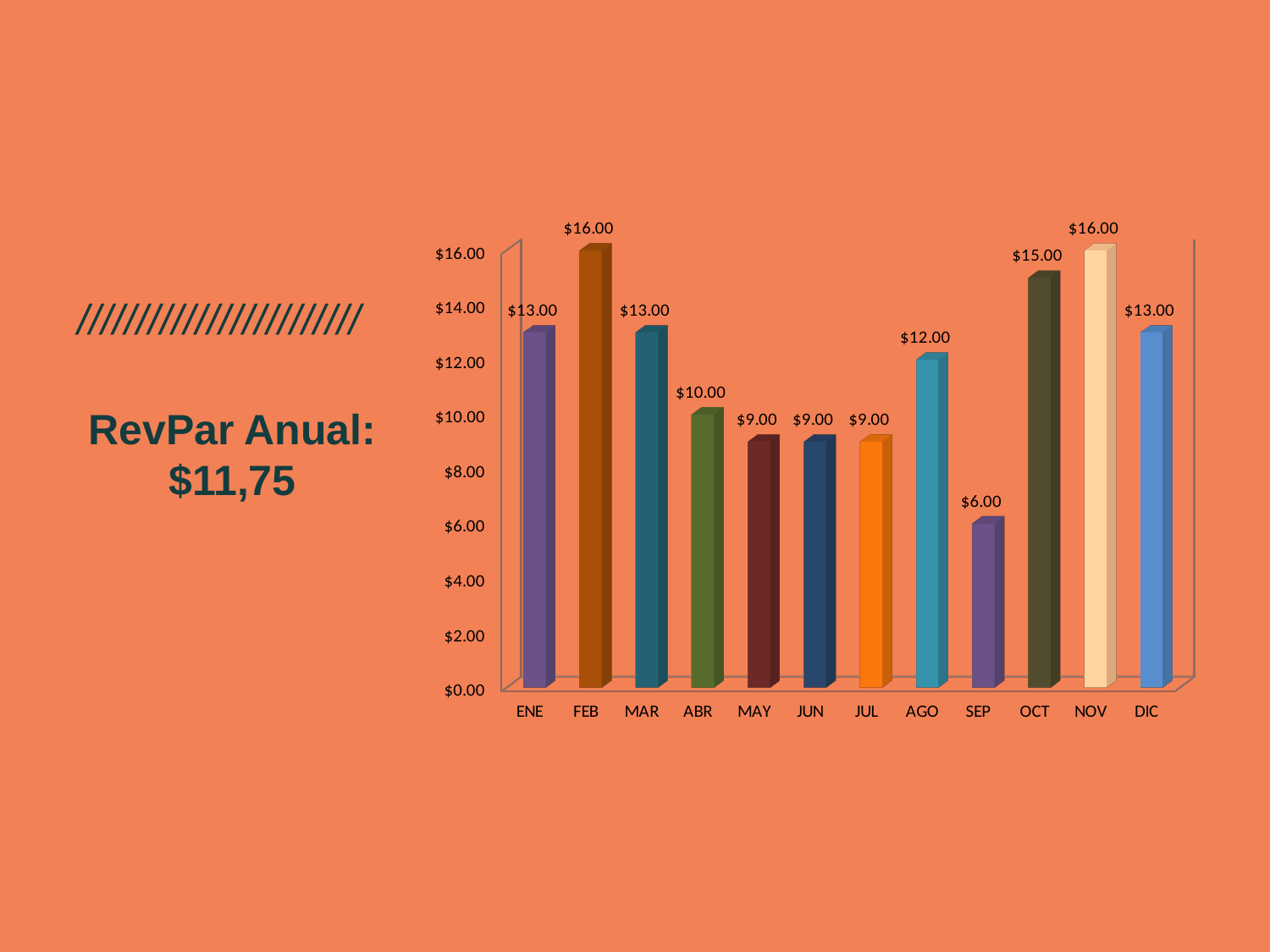
How many months are shown on the x axis? 12 What is the value for SEP? $6.00 Is the value for NOV greater or less than $14.00? greater Which month has the lowest value? SEP What is the difference between the values for OCT and SEP? $9.00 Do the values rise or fall from ABR to JUL? fall What is the value for AGO? $12.00 What is the value for FEB? $16.00 Which is larger, the value for MAR or the value for ABR? MAR What kind of chart is shown on the slide? bar chart What is the value for OCT? $15.00 What is the difference between the values for FEB and ABR? $6.00